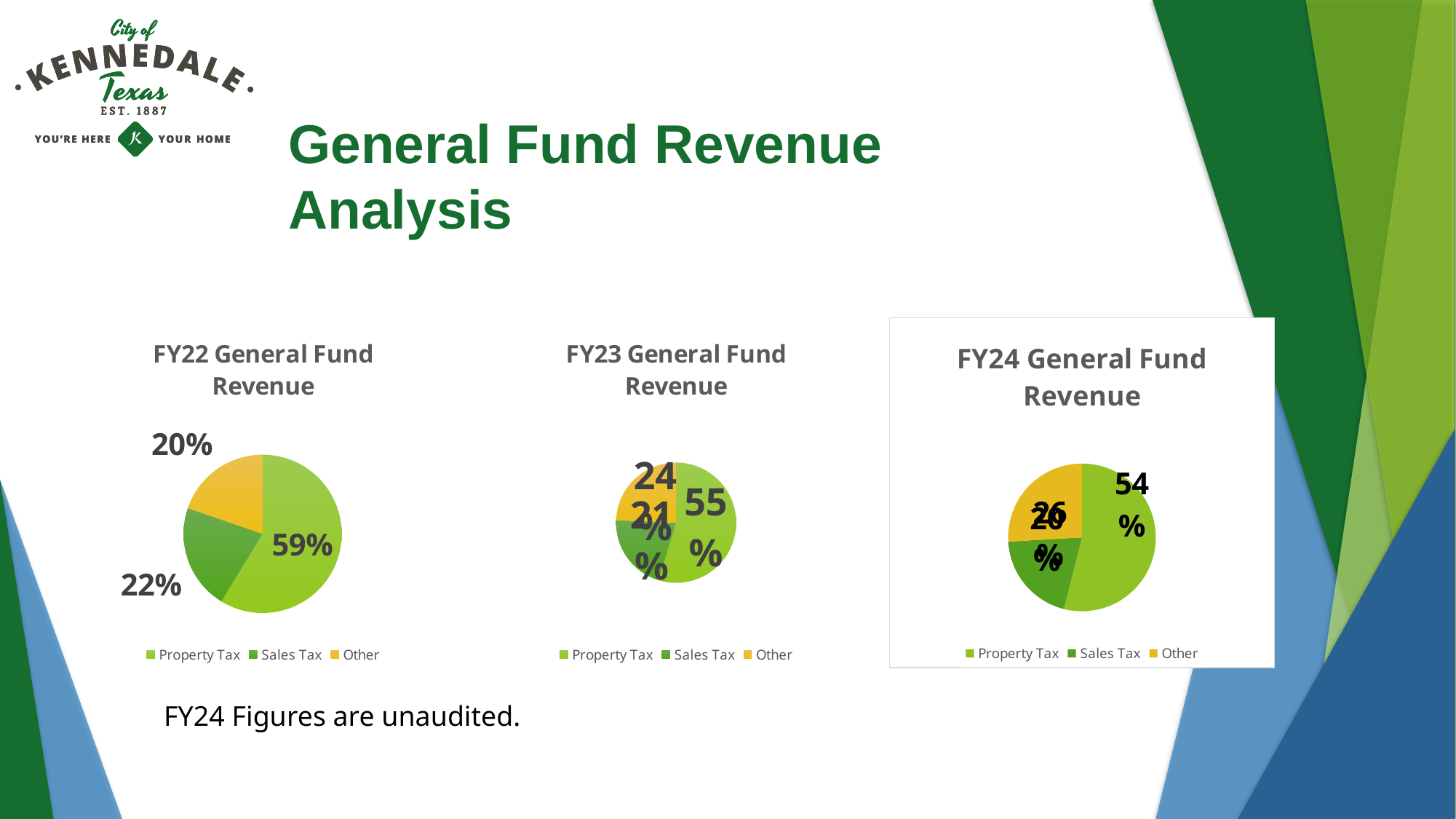
In the FY22 General Fund Revenue chart, what share of revenue comes from Sales Tax? 22% Which is larger: the Property Tax share in the FY22 chart or the Property Tax share in the FY23 chart? FY22 In the FY22 General Fund Revenue chart, which category has the smallest share? Other What kind of chart is the FY22 General Fund Revenue chart? Pie chart How many categories does the legend of the FY24 General Fund Revenue chart list? 3 In the FY22 General Fund Revenue chart, how many percentage points larger is the Property Tax share than the Sales Tax share? 37 percentage points How many charts are shown on the slide? 3 In the FY23 General Fund Revenue chart, what share of revenue comes from Property Tax? 55% In the FY22 General Fund Revenue chart, what share of revenue comes from Other? 20% In the FY22 General Fund Revenue chart, which category has the largest share? Property Tax In the FY22 General Fund Revenue chart, what share of revenue comes from Property Tax? 59% In the FY24 General Fund Revenue chart, what share of revenue comes from Property Tax? 54%